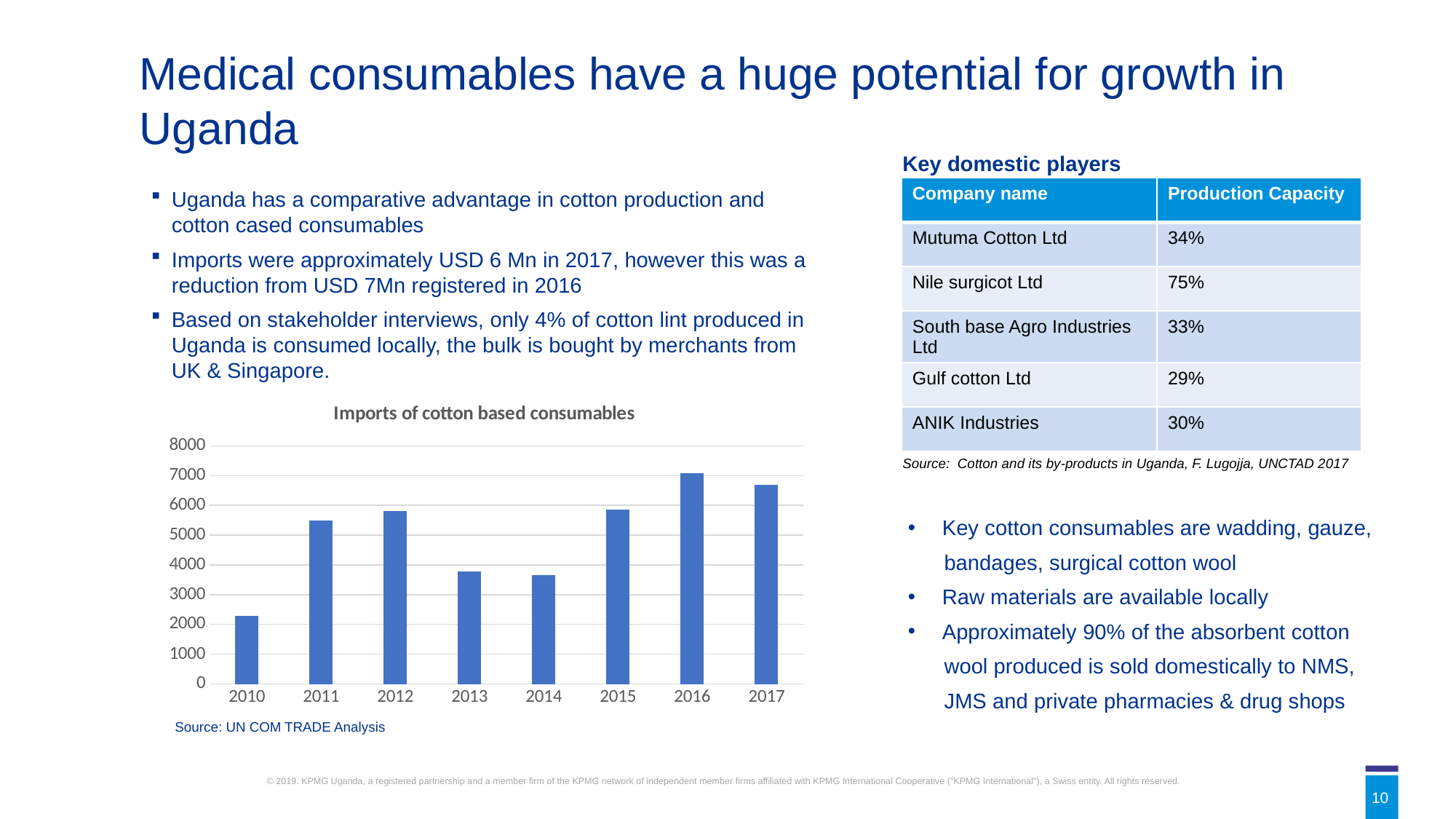
What kind of chart is 'Imports of cotton based consumables'? bar chart In the 'Imports of cotton based consumables' chart, is the value for 2013 greater or less than 4000? less In the 'Imports of cotton based consumables' chart, do the values rise or fall from 2014 to 2016? rise In the 'Imports of cotton based consumables' chart, which year has the lowest value? 2010 In the 'Imports of cotton based consumables' chart, which is larger, the value for 2016 or the value for 2017? 2016 In the 'Imports of cotton based consumables' chart, which is larger, the value for 2011 or the value for 2013? 2011 In the 'Imports of cotton based consumables' chart, is the value for 2010 greater or less than 3000? less In the 'Imports of cotton based consumables' chart, is the value for 2017 greater or less than 6000? greater How many years are shown on the x axis of the 'Imports of cotton based consumables' chart? 8 What is the title of the bar chart on the slide? Imports of cotton based consumables In the 'Imports of cotton based consumables' chart, which year has the highest value? 2016